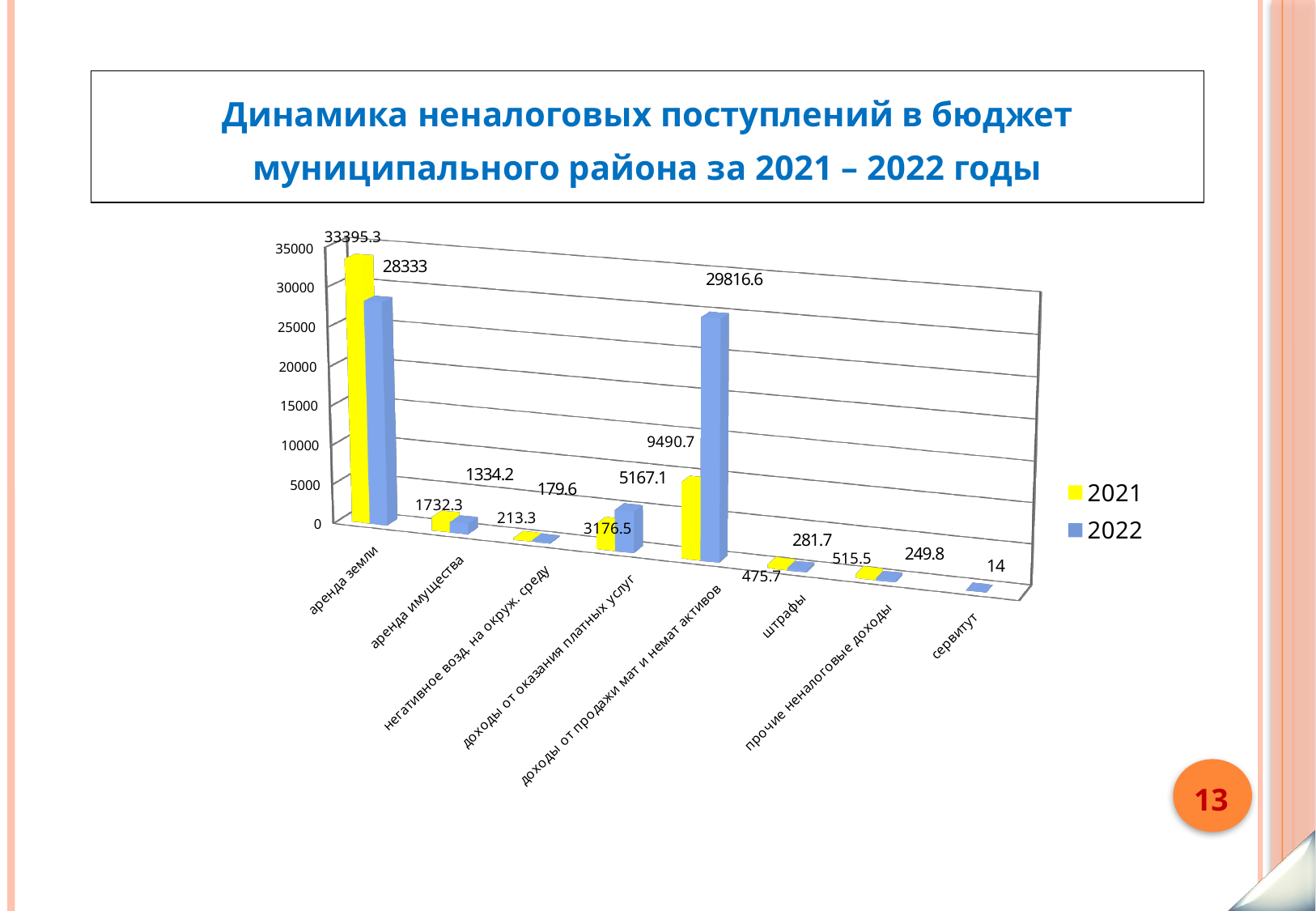
What is the value for штрафы in 2021? 475.7 Which category has the lowest value in the 2022 series? сервитут How many series does the legend list? 2 What is the value for доходы от продажи мат и немат активов in 2022? 29816.6 What is the difference between the 2021 and 2022 values for аренда земли? 5062.3 What type of chart is shown on the slide? bar chart What is the value for аренда земли in 2021? 33395.3 What is the value for сервитут in 2022? 14 How many categories are shown on the x axis? 8 Which category has the highest value in the 2022 series? доходы от продажи мат и немат активов Which colour represents the 2021 series in the legend? yellow Which is larger for доходы от оказания платных услуг: the 2021 value or the 2022 value? 2022